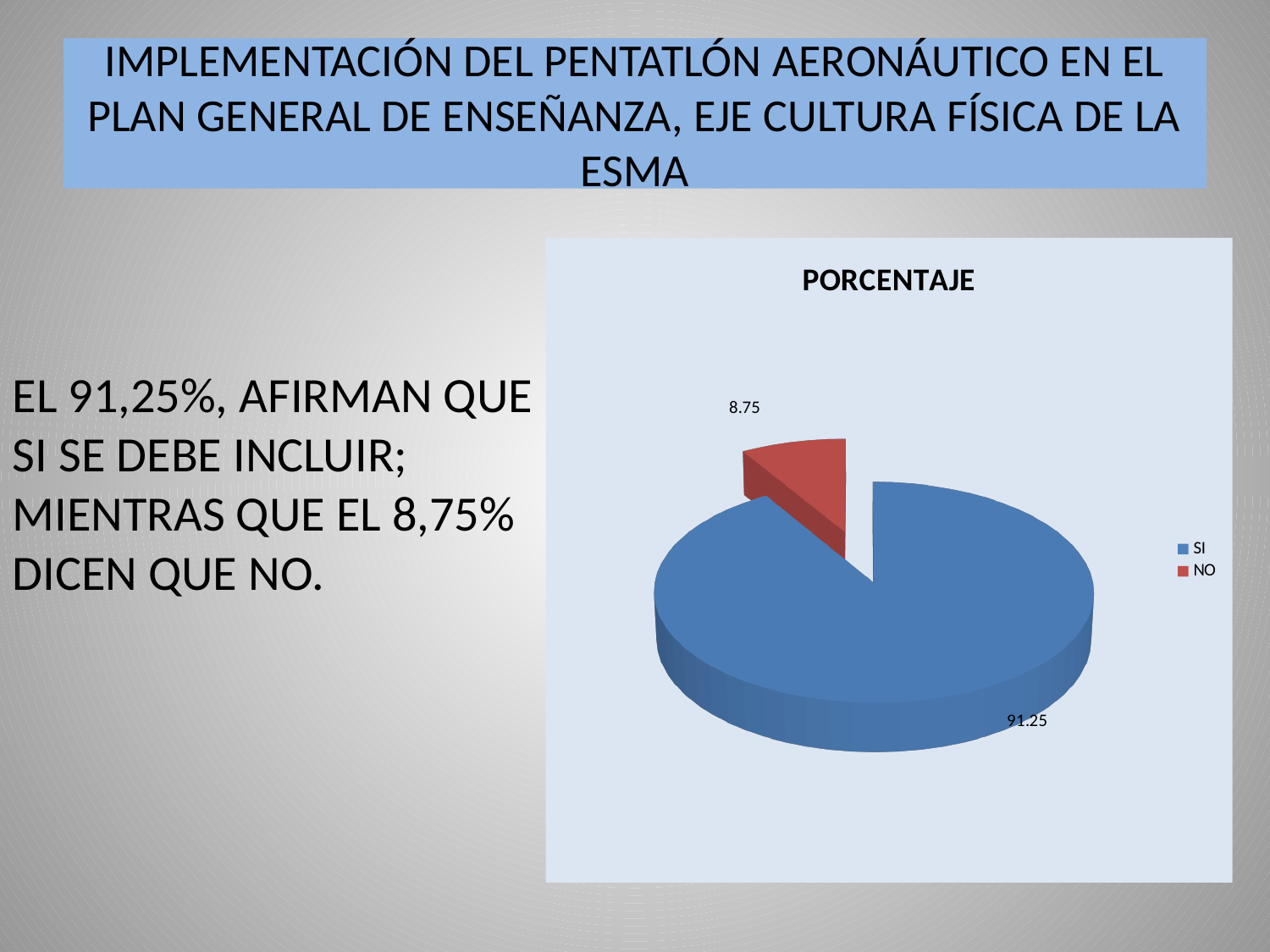
Which category has the smallest slice? NO What is the total of the two slice values? 100 What colour is the NO slice? Red What is the value for the NO slice? 8.75 What is the title of the chart? PORCENTAJE How many entries does the legend list? 2 Which category has the largest slice? SI How many slices does the pie chart have? 2 What is the value for the SI slice? 91.25 Which is larger, the value for SI or the value for NO? SI What is the difference between the SI and NO values? 82.5 What type of chart is shown on the slide? Pie chart